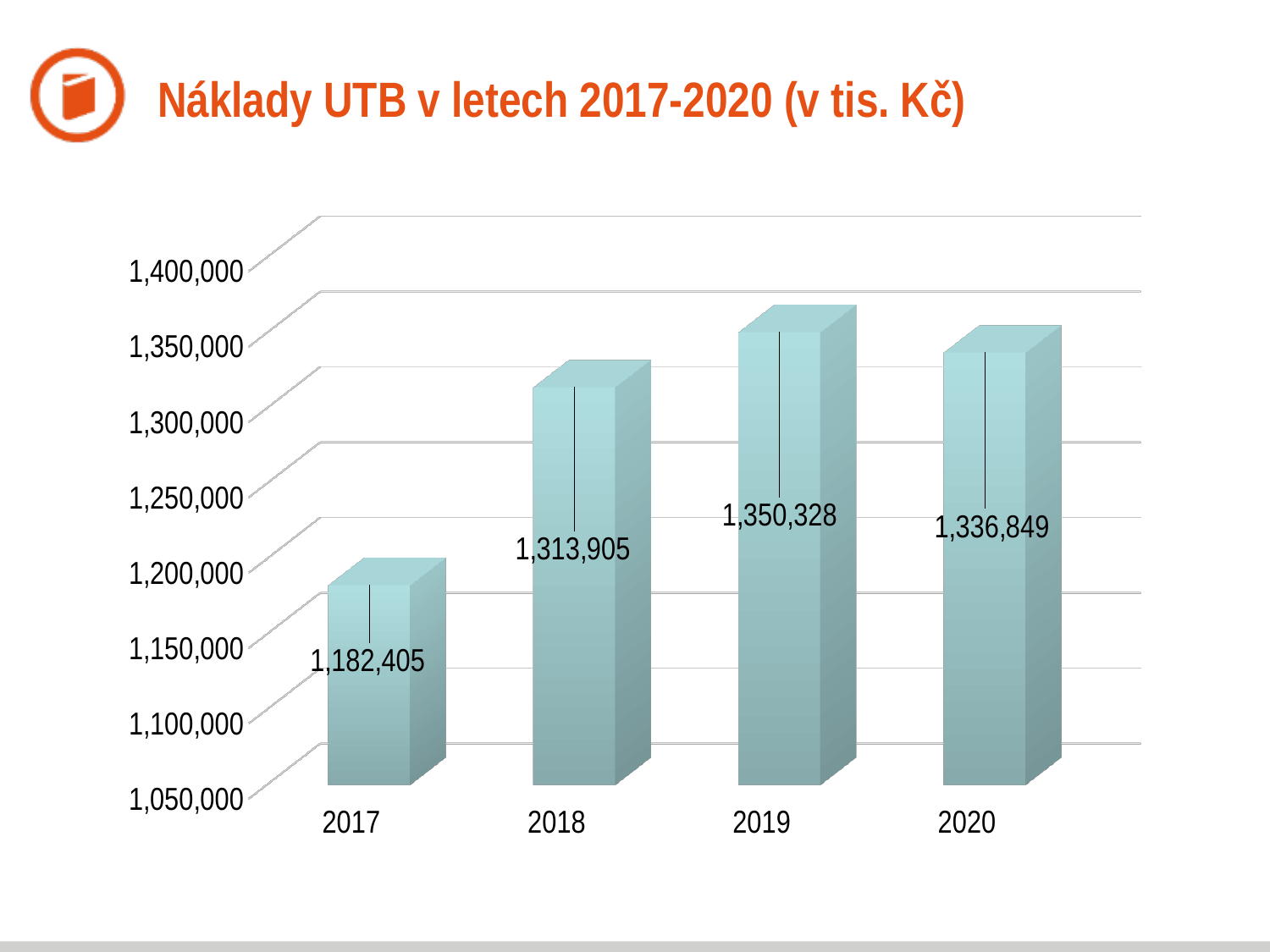
What kind of chart is shown on the slide? bar chart What is the value for 2020? 1,336,849 Which year has the highest value? 2019 What is the difference between the values for 2018 and 2017? 131,500 Is the value for 2018 greater or less than 1,300,000? greater What is the value for 2017? 1,182,405 What is the value for 2019? 1,350,328 How many years are shown on the x axis? 4 What is the difference between the values for 2019 and 2020? 13,479 What is the title of the slide? Náklady UTB v letech 2017-2020 (v tis. Kč) Which year has the lowest value? 2017 Which is larger, the value for 2018 or the value for 2020? 2020